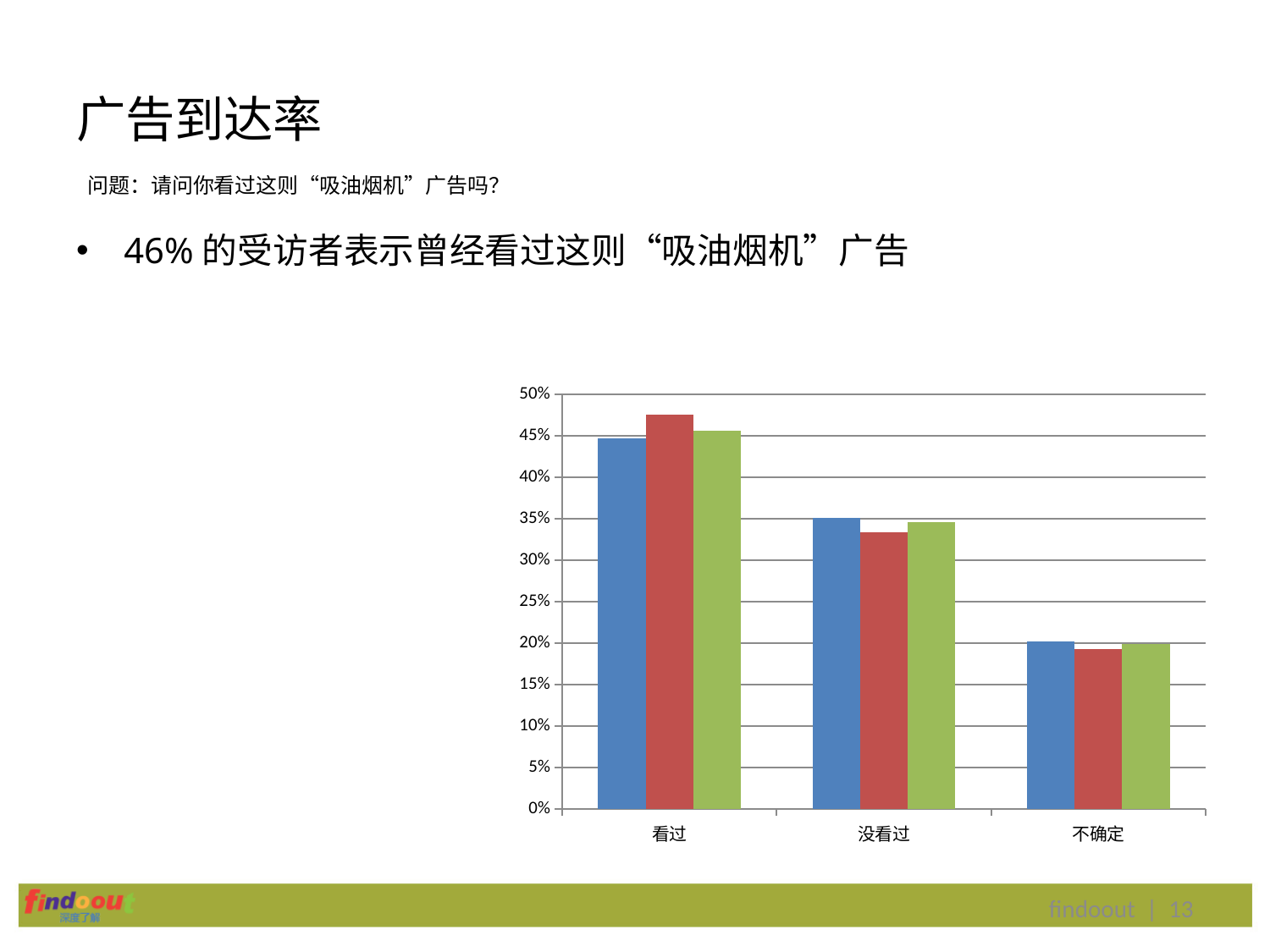
Is the value of the blue bar for 看过 greater or less than 40%? greater How many categories are shown on the x axis of the chart? 3 Which category has the lowest bars in the chart? 不确定 Is the value of the red bar for 没看过 greater or less than 35%? less Is the value of the red bar for 看过 greater or less than 45%? greater Do the values rise or fall moving from 看过 to 不确定 along the x axis? fall Which category has the highest bars in the chart? 看过 For the category 没看过, which bar is taller, the blue bar or the red bar? the blue bar What kind of chart is shown on the slide? bar chart For the category 看过, which bar is taller, the blue bar or the red bar? the red bar